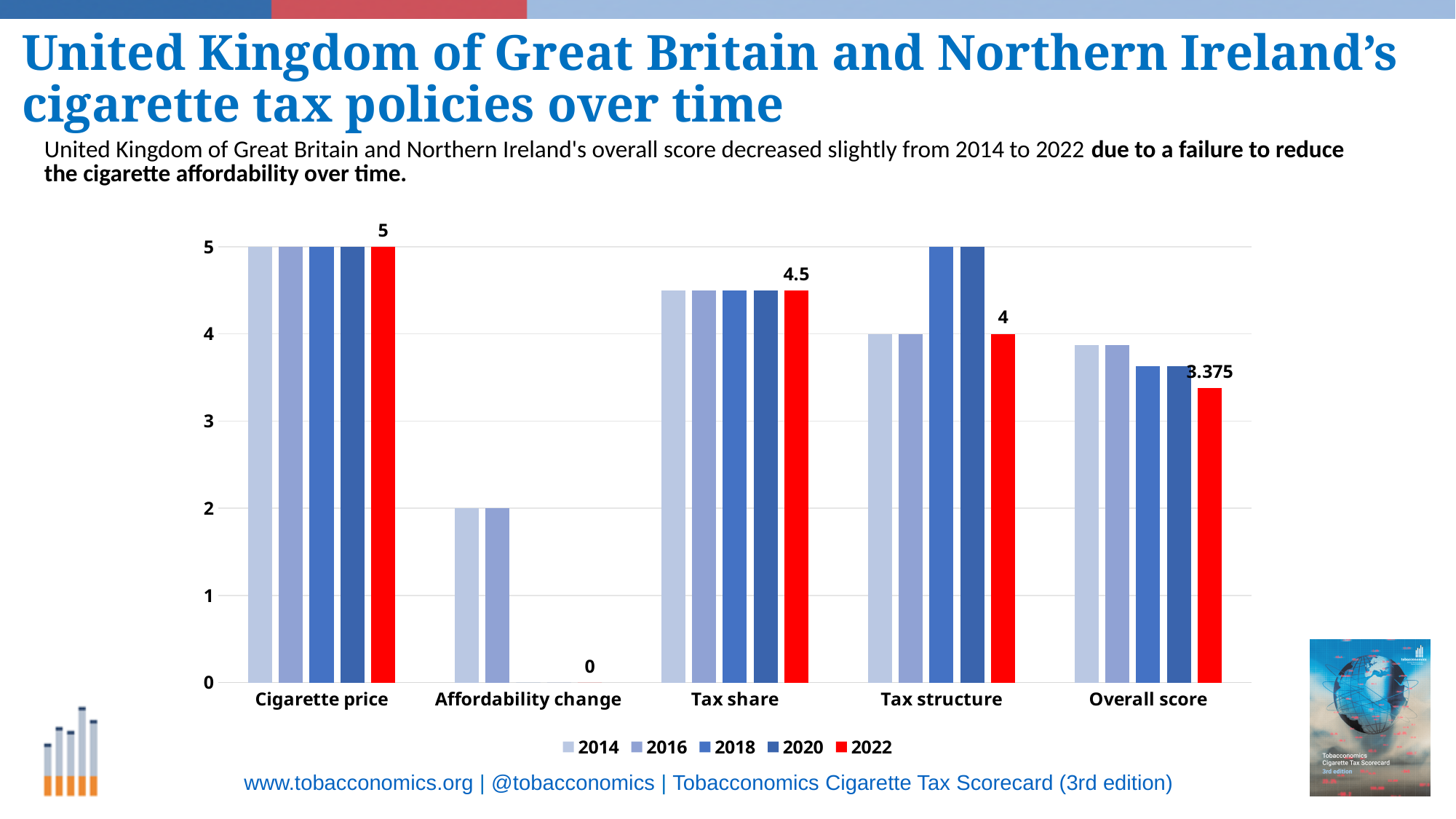
What is the 2022 value for Tax share? 4.5 For Tax structure, which is larger: the 2018 value or the 2022 value? 2018 What is the 2014 value for Affordability change? 2 Which category has the lowest 2022 value? Affordability change What kind of chart is shown on the slide? bar chart How many series does the legend list? 5 What is the 2022 value for Tax structure? 4 Is the 2014 value for Overall score greater or less than 3? greater Which category has the highest 2022 value? Cigarette price What is the 2022 value for Overall score? 3.375 What is the difference between the 2022 values for Cigarette price and Overall score? 1.625 What is the 2022 value for Affordability change? 0